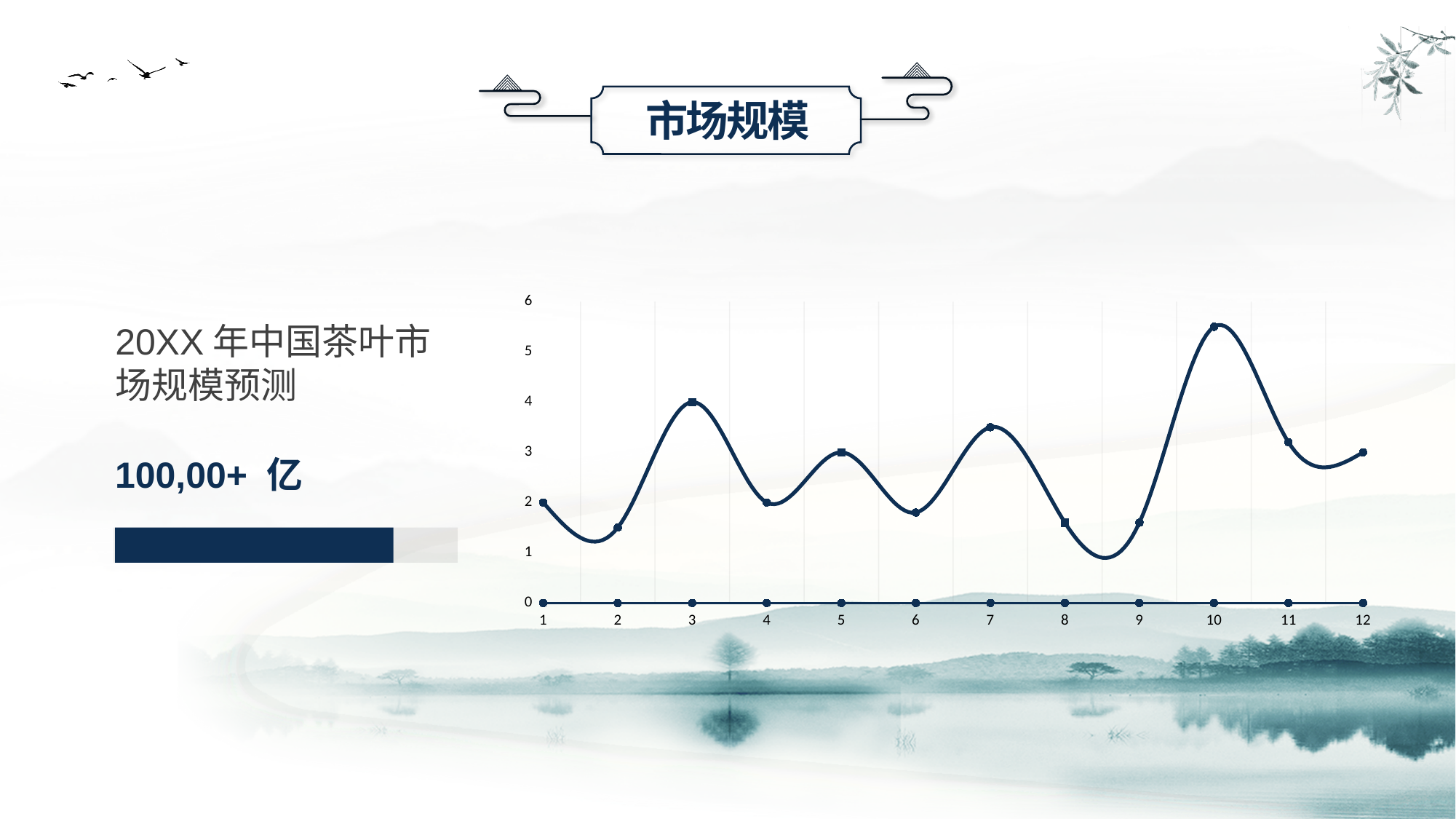
What kind of chart is shown on the slide? line chart Is the value of the curved line at x = 7 greater or less than 3? greater At which x-axis category does the curved line reach its highest value? 10 How many points are plotted along the x axis of the chart? 12 Which is larger on the curved line: the value at x = 3 or the value at x = 5? x = 3 What is the value of the curved line at x = 1? 2 Is the value of the curved line at x = 2 greater or less than 2? less What is the value of the curved line at x = 3? 4 What is the difference between the curved line's value at x = 3 and its value at x = 1? 2 What is the highest value shown on the chart's y axis? 6 Is the value of the curved line at x = 10 greater or less than 5? greater What is the value of the curved line at x = 5? 3